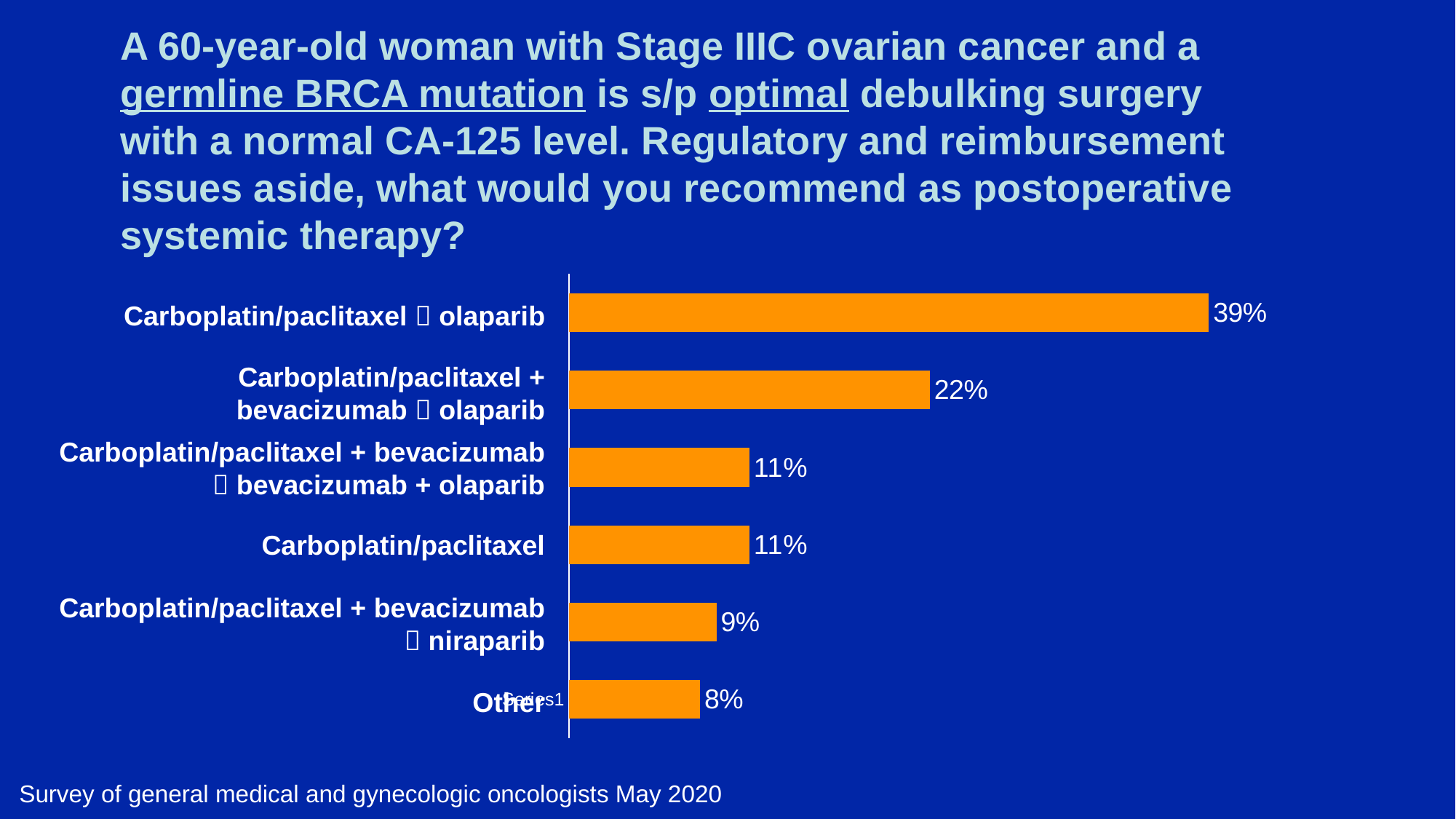
What percentage is shown for Carboplatin/paclitaxel + bevacizumab followed by niraparib? 9% How many categories are plotted in the chart? 6 Which category has the lowest percentage? Other What percentage is shown for the top bar, Carboplatin/paclitaxel followed by olaparib? 39% Which is larger: the value for Carboplatin/paclitaxel + bevacizumab followed by niraparib or the value for Other? Carboplatin/paclitaxel + bevacizumab followed by niraparib What percentage is shown for Carboplatin/paclitaxel alone? 11% Which category has the highest percentage? Carboplatin/paclitaxel followed by olaparib (top bar) According to the footnote, who was surveyed and when? General medical and gynecologic oncologists, May 2020 What colour are the bars in the chart? Orange What kind of chart is shown on the slide? Bar chart What percentage is shown for the Other category? 8% What is the difference between the top bar (39%) and the second bar, Carboplatin/paclitaxel + bevacizumab followed by olaparib? 17 percentage points